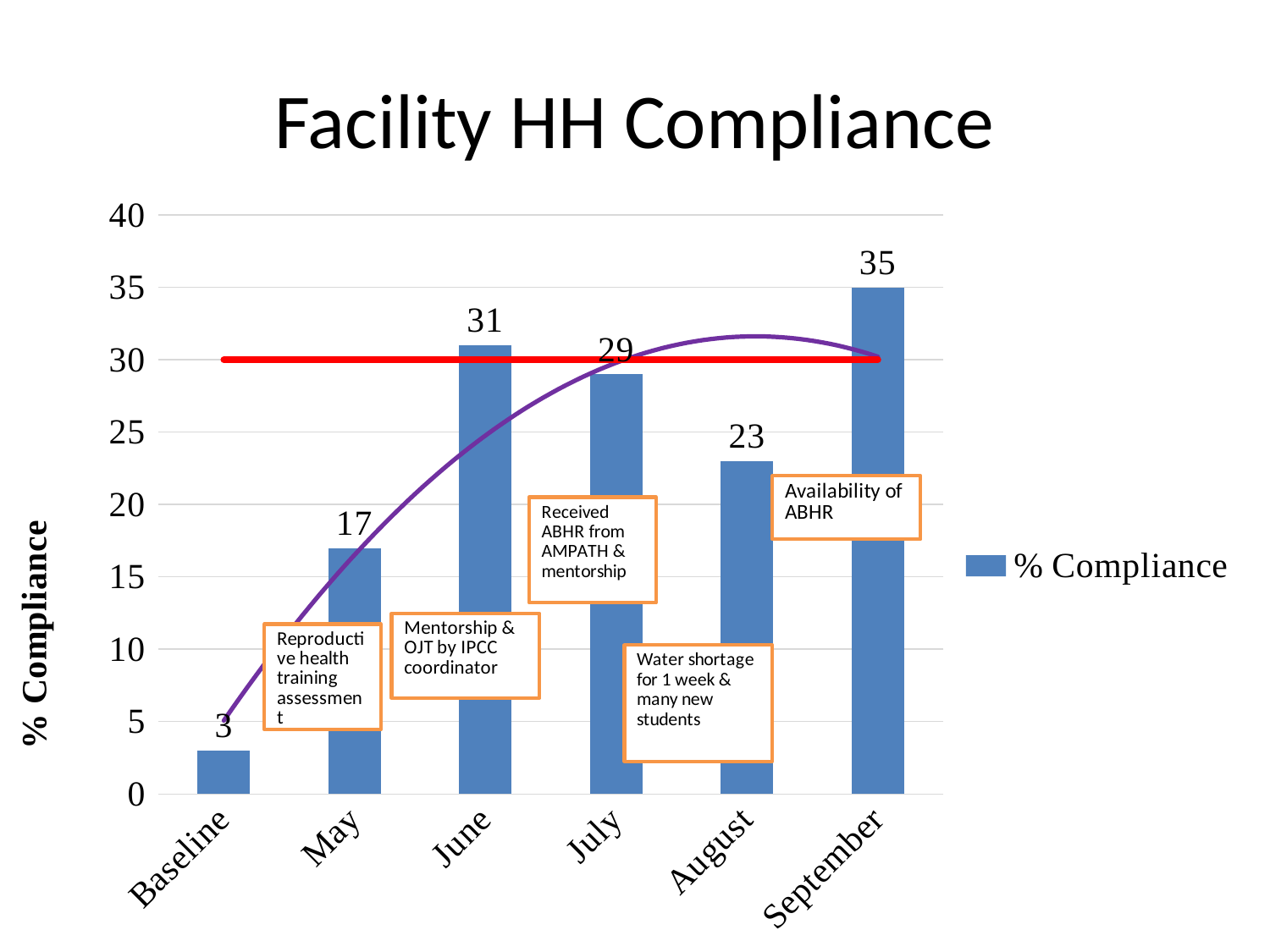
Which has a higher % Compliance, June or July? June What is the title of the chart? Facility HH Compliance What is the % Compliance value for June? 31 Is the value for May greater or less than 20? less What is the % Compliance value for Baseline? 3 Which category has the highest % Compliance? September How many series does the legend list? 1 What is the difference in % Compliance between September and August? 12 How many categories are shown on the x axis? 6 Which category has the lowest % Compliance? Baseline What kind of chart is shown on the slide? bar chart What is the % Compliance value for August? 23